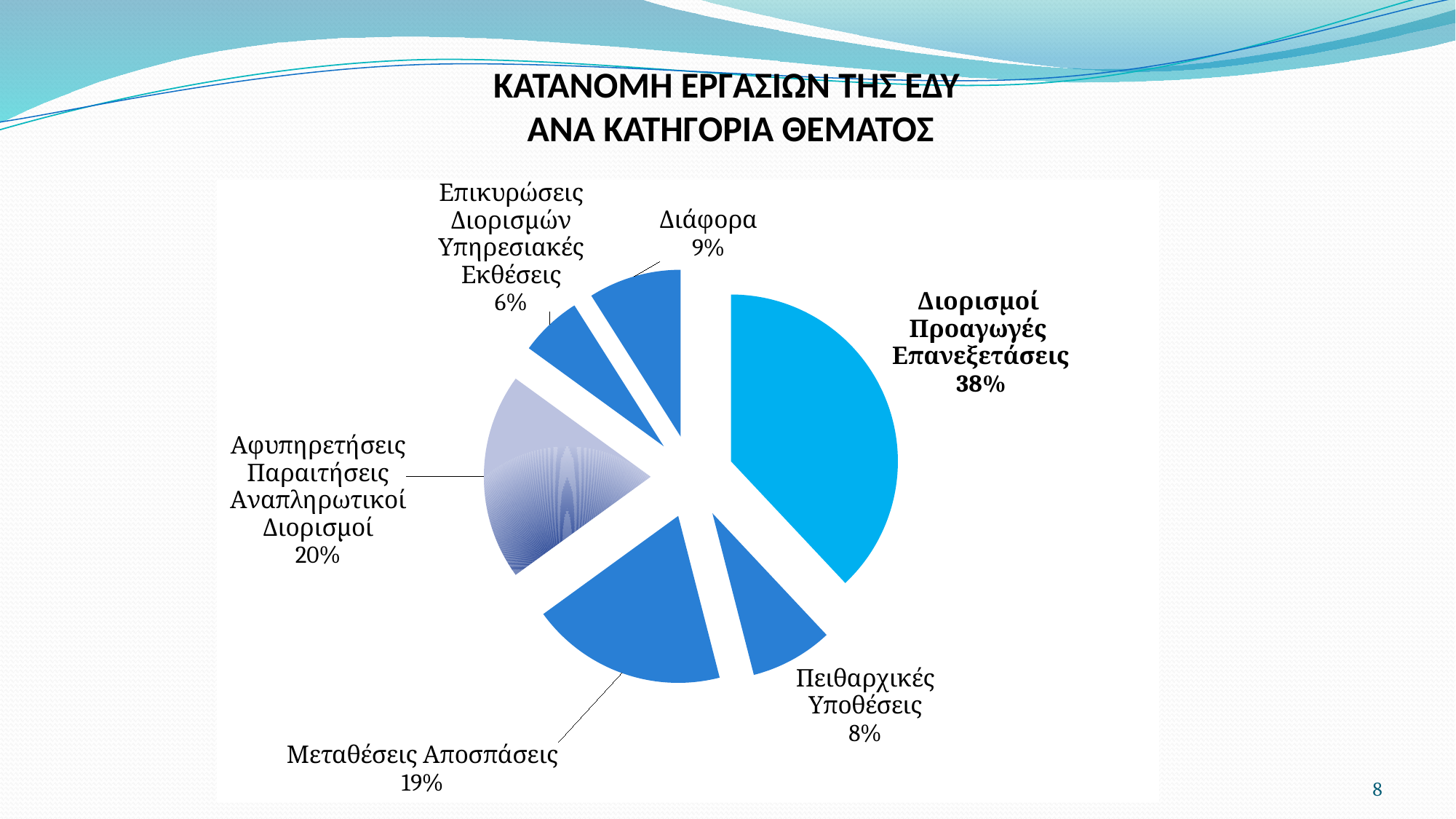
What is the title of the chart? ΚΑΤΑΝΟΜΗ ΕΡΓΑΣΙΩΝ ΤΗΣ ΕΔΥ ΑΝΑ ΚΑΤΗΓΟΡΙΑ ΘΕΜΑΤΟΣ What percentage is shown for Αφυπηρετήσεις Παραιτήσεις Αναπληρωτικοί Διορισμοί? 20% What percentage is shown for Επικυρώσεις Διορισμών Υπηρεσιακές Εκθέσεις? 6% What share of the pie is labelled Διορισμοί Προαγωγές Επανεξετάσεις? 38% What type of chart is shown on the slide? Pie chart Which is larger, the share for Μεταθέσεις Αποσπάσεις or the share for Διάφορα? Μεταθέσεις Αποσπάσεις How many slices does the pie chart have? 6 Which category has the largest share of the pie? Διορισμοί Προαγωγές Επανεξετάσεις Which category has the smallest share of the pie? Επικυρώσεις Διορισμών Υπηρεσιακές Εκθέσεις What is the difference in percentage points between Διορισμοί Προαγωγές Επανεξετάσεις and Διάφορα? 29 What percentage is shown for Μεταθέσεις Αποσπάσεις? 19% What percentage is shown for Πειθαρχικές Υποθέσεις? 8%